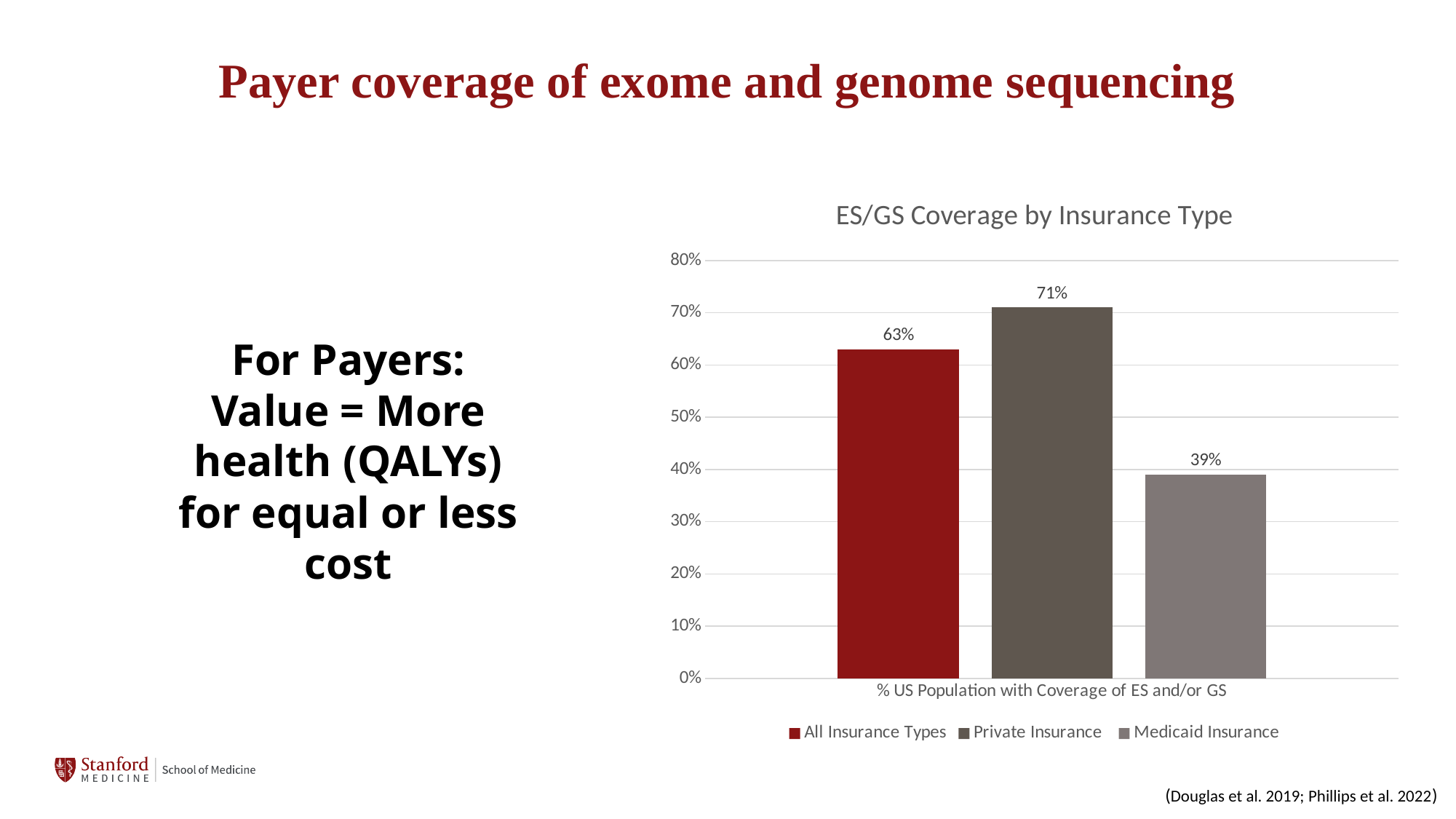
Which series has the lowest coverage value? Medicaid Insurance What is the difference between the Private Insurance and All Insurance Types values? 8% What is the difference between the Private Insurance and Medicaid Insurance values? 32% What is the value for Medicaid Insurance? 39% How many series does the legend list? 3 Which is larger, the value for All Insurance Types or the value for Medicaid Insurance? All Insurance Types What is the value for All Insurance Types? 63% What kind of chart is shown on the slide? bar chart Which series has the highest coverage value? Private Insurance What is the title of the chart? ES/GS Coverage by Insurance Type What is the value for Private Insurance? 71% Is the value for Medicaid Insurance greater or less than 50%? less